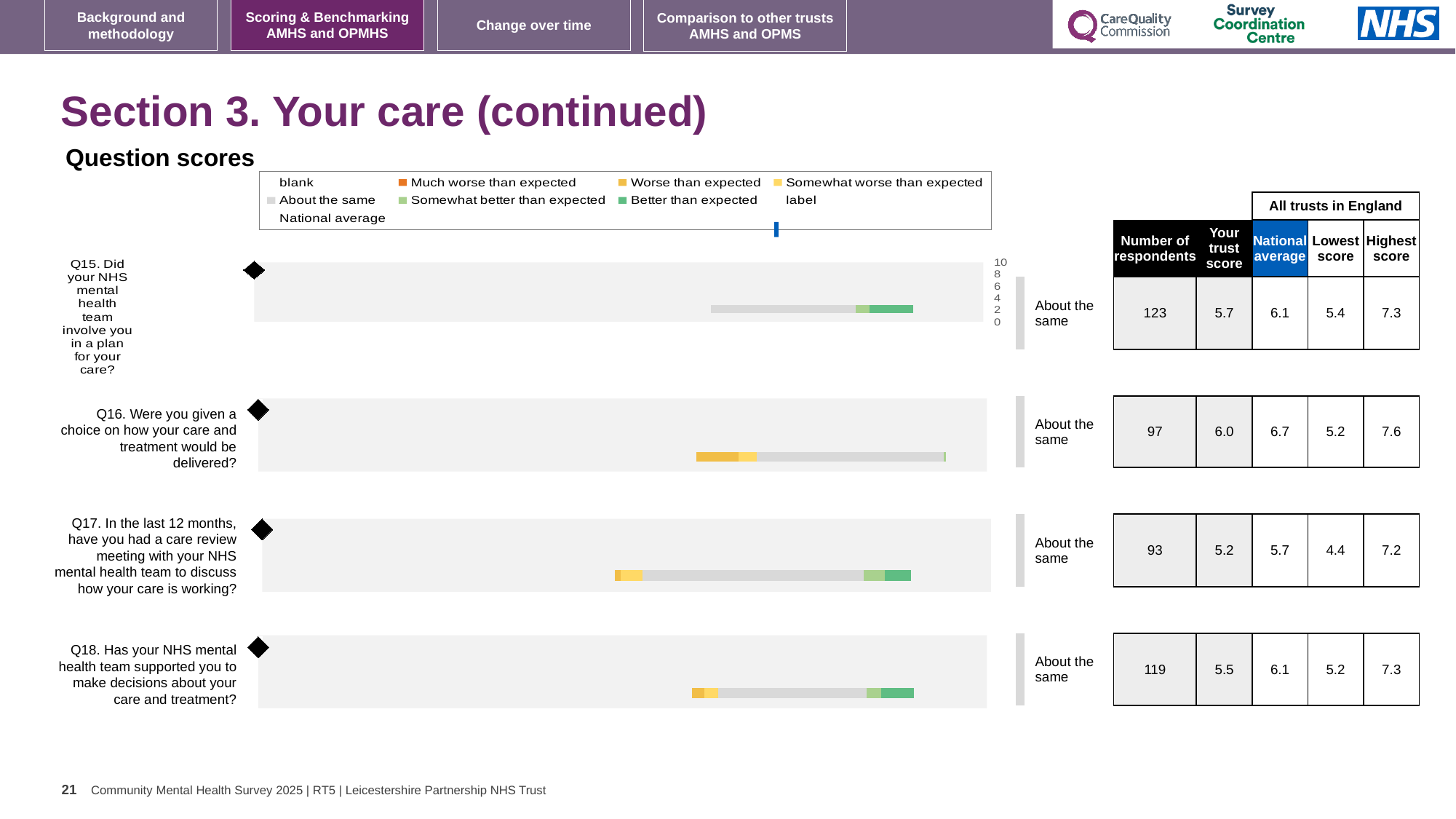
For Q15, which is larger: the trust score or the national average? National average How many questions (Q15 to Q18) have a bar chart on the slide? 4 What kind of chart is used to show the question scores for Q15 to Q18? bar chart For Q16, what is the difference between the national average (6.7) and the trust score (6.0)? 0.7 What benchmark label is shown to the right of each of the four bar charts? About the same What is the national average score for Q16 (choice on how your care and treatment would be delivered)? 6.7 What is the 'Your trust score' value for Q15 (involving you in a plan for your care)? 5.7 Which question has the lowest 'Your trust score' on the slide? Q17 What is the highest score across all trusts in England for Q18 (supported to make decisions about care and treatment)? 7.3 How many respondents answered Q17 (care review meeting in the last 12 months)? 93 Which question has the largest number of respondents? Q15 Which question has the highest 'Your trust score' on the slide? Q16